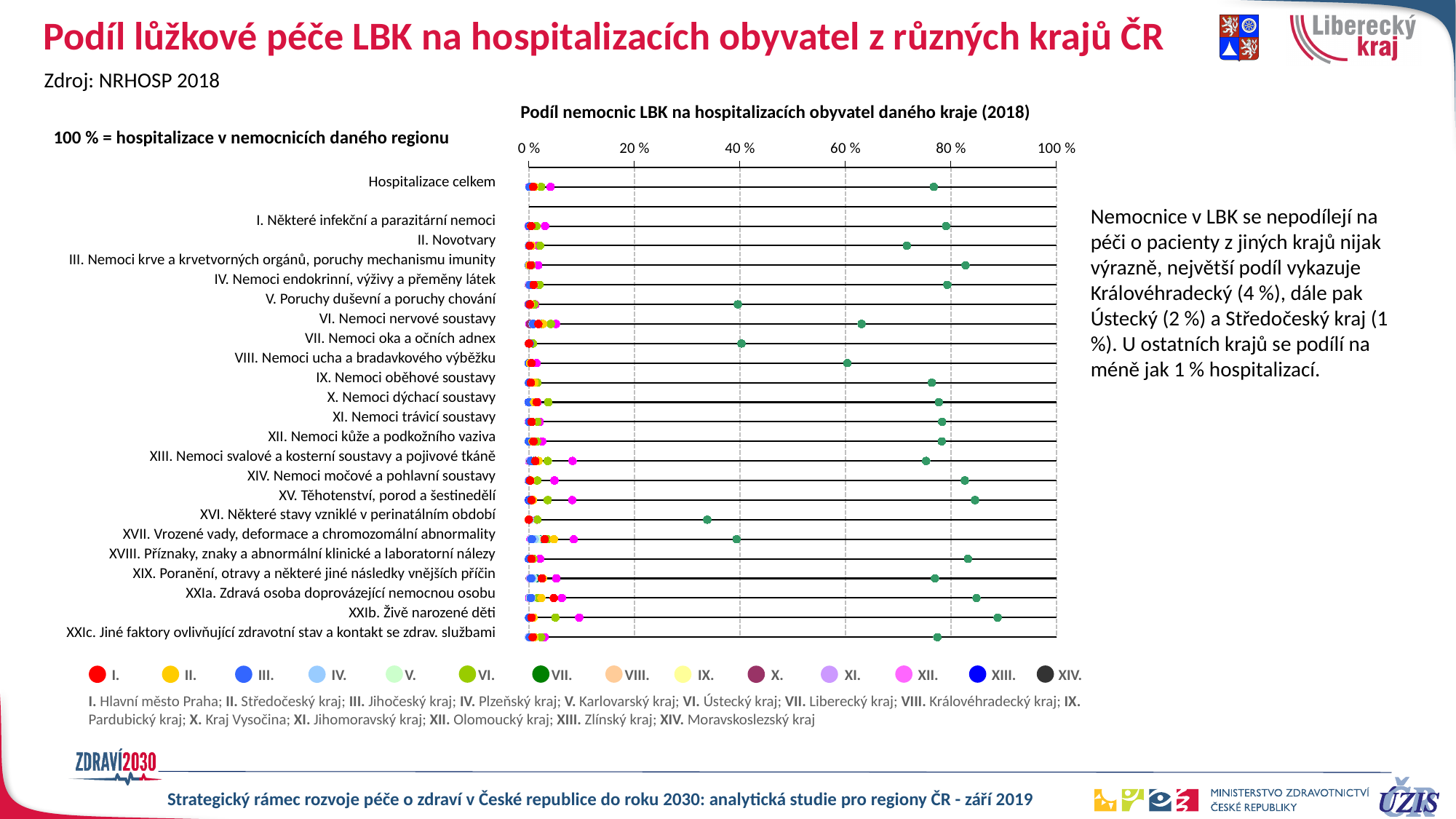
Which region does legend entry VII. represent? Liberecký kraj How many series (regions) does the chart legend list? 14 Is the value for VII. Liberecký kraj in the row 'XXIb. Živě narozené děti' greater or less than 80 %? greater Is the value for VII. Liberecký kraj in the row 'II. Novotvary' greater or less than 60 %? greater For VII. Liberecký kraj, which diagnosis row has the lowest value? XVI. Některé stavy vzniklé v perinatálním období What kind of chart is shown on the slide? dot plot Is the value for VII. Liberecký kraj in the row 'XVI. Některé stavy vzniklé v perinatálním období' greater or less than 40 %? less What is the title of the chart? Podíl nemocnic LBK na hospitalizacích obyvatel daného kraje (2018) How many diagnosis categories (rows) are plotted in the chart, including 'Hospitalizace celkem'? 23 For VII. Liberecký kraj, which row has the larger value: 'XXIb. Živě narozené děti' or 'XVI. Některé stavy vzniklé v perinatálním období'? XXIb. Živě narozené děti